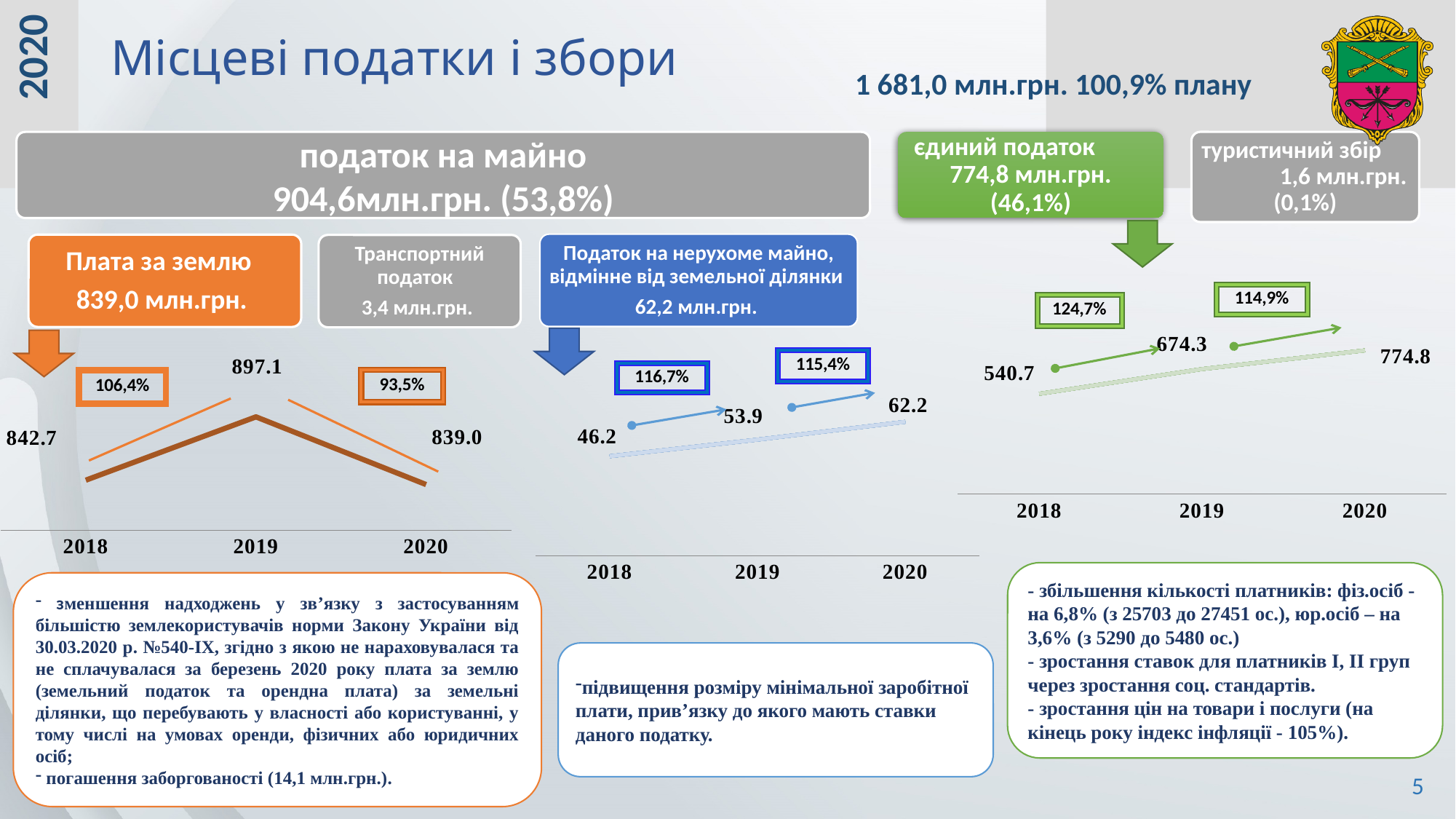
In the right chart (єдиний податок), what is the value for 2019? 674.3 In the left chart (Плата за землю), which is larger, the value for 2018 or the value for 2020? 2018 In the left chart (Плата за землю), what is the difference between the 2019 and 2020 values? 58.1 How many years are plotted in the right chart (єдиний податок)? 3 In the middle chart (Податок на нерухоме майно), what is the difference between the 2020 and 2018 values? 16.0 What kind of chart is the middle chart (Податок на нерухоме майно)? line chart In the middle chart (Податок на нерухоме майно), what is the value for 2018? 46.2 In the middle chart (Податок на нерухоме майно), do the values rise or fall from 2018 to 2020? rise In the left chart (Плата за землю), which year has the lowest value? 2020 In the right chart (єдиний податок), what is the difference between the 2019 and 2018 values? 133.6 In the left chart (Плата за землю), what is the value for 2019? 897.1 In the right chart (єдиний податок), which year has the highest value? 2020